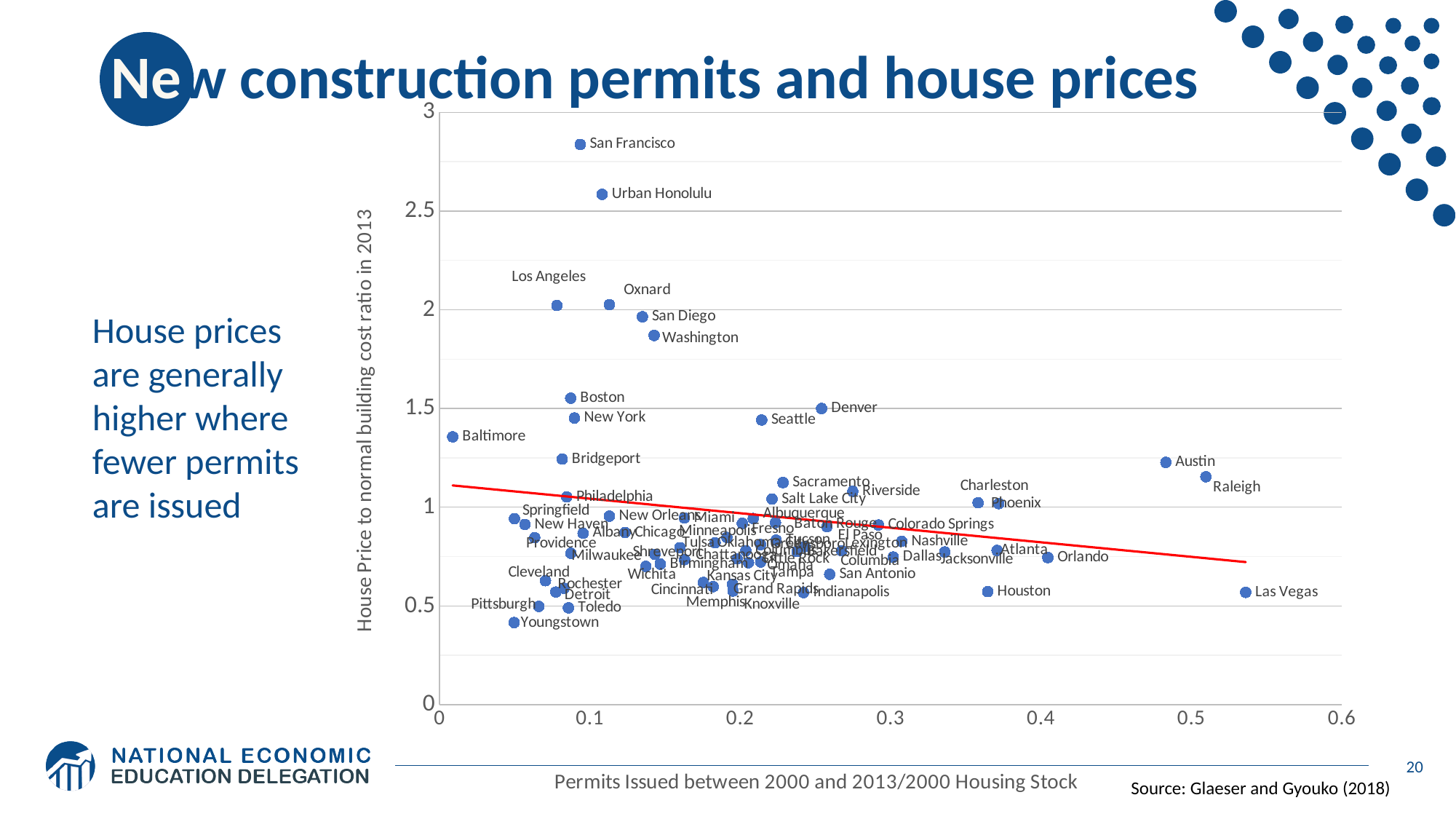
Which city has a higher house price ratio, San Francisco or Urban Honolulu? San Francisco Which city has the highest value on the x axis (permits issued relative to housing stock)? Las Vegas What kind of chart is shown on the slide? Scatter chart Which city has the highest house price to normal building cost ratio? San Francisco Which city has the lowest house price to normal building cost ratio? Youngstown Is the house price ratio for Washington greater or less than 2? less Which city has a higher house price ratio, Baltimore or Houston? Baltimore Which city has the lowest value on the x axis (permits issued relative to housing stock)? Baltimore What is the label of the x axis? Permits Issued between 2000 and 2013/2000 Housing Stock Is the house price ratio for Las Vegas greater or less than 1? less Is the house price ratio for San Francisco greater or less than 2.5? greater According to the red trend line, do house price ratios rise or fall as the permits ratio increases along the x axis? fall